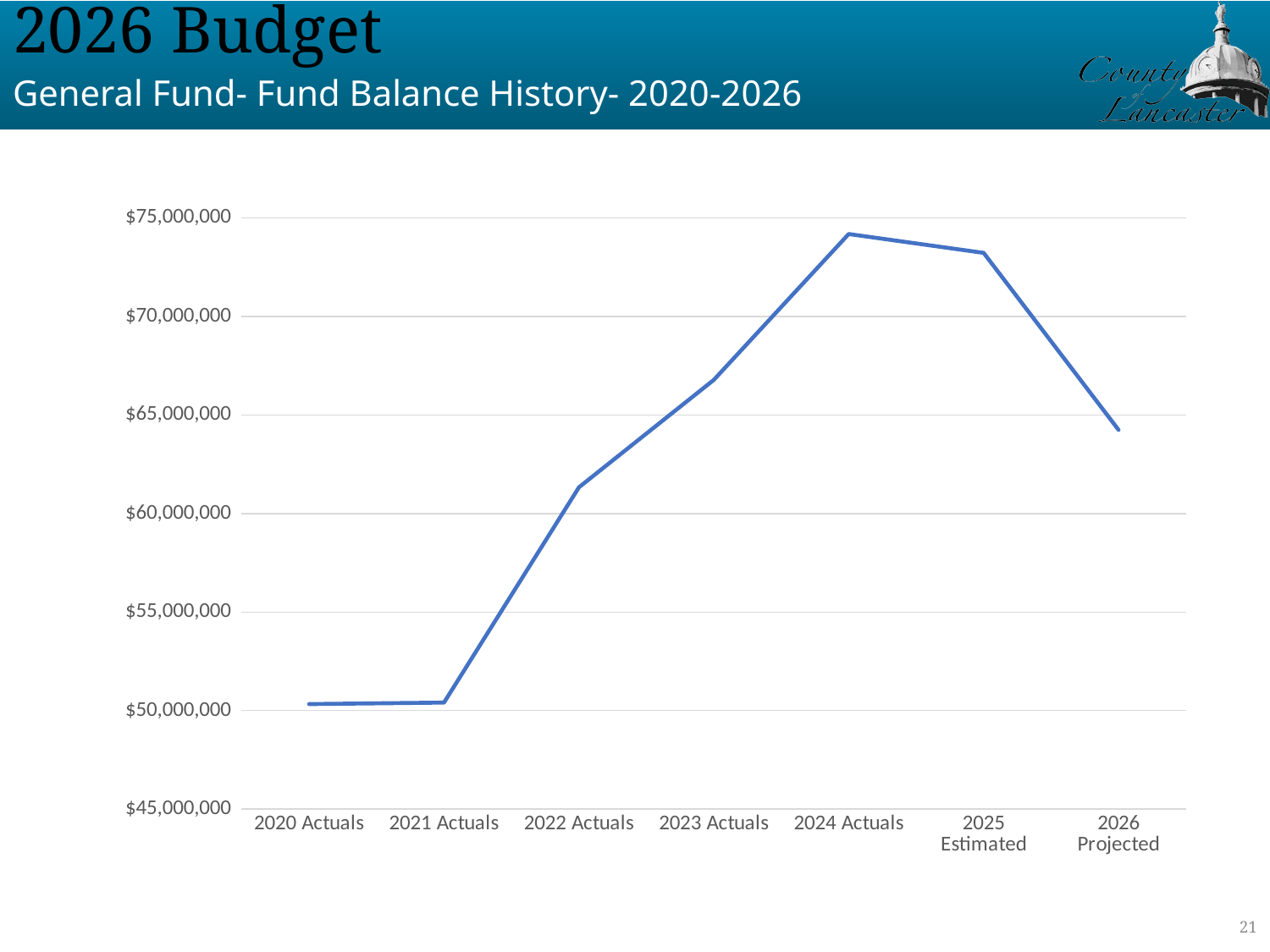
How many points are plotted on the line chart? 7 Is the value for 2020 Actuals greater or less than $55,000,000? less What kind of chart is shown on the slide? line chart Is the value for 2022 Actuals greater or less than $60,000,000? greater Is the value for 2023 Actuals greater or less than $65,000,000? greater Which category has the highest fund balance? 2024 Actuals Do the values rise or fall from 2020 Actuals to 2024 Actuals? rise Which is larger, the value for 2022 Actuals or 2023 Actuals? 2023 Actuals Which is larger, the value for 2025 Estimated or 2026 Projected? 2025 Estimated